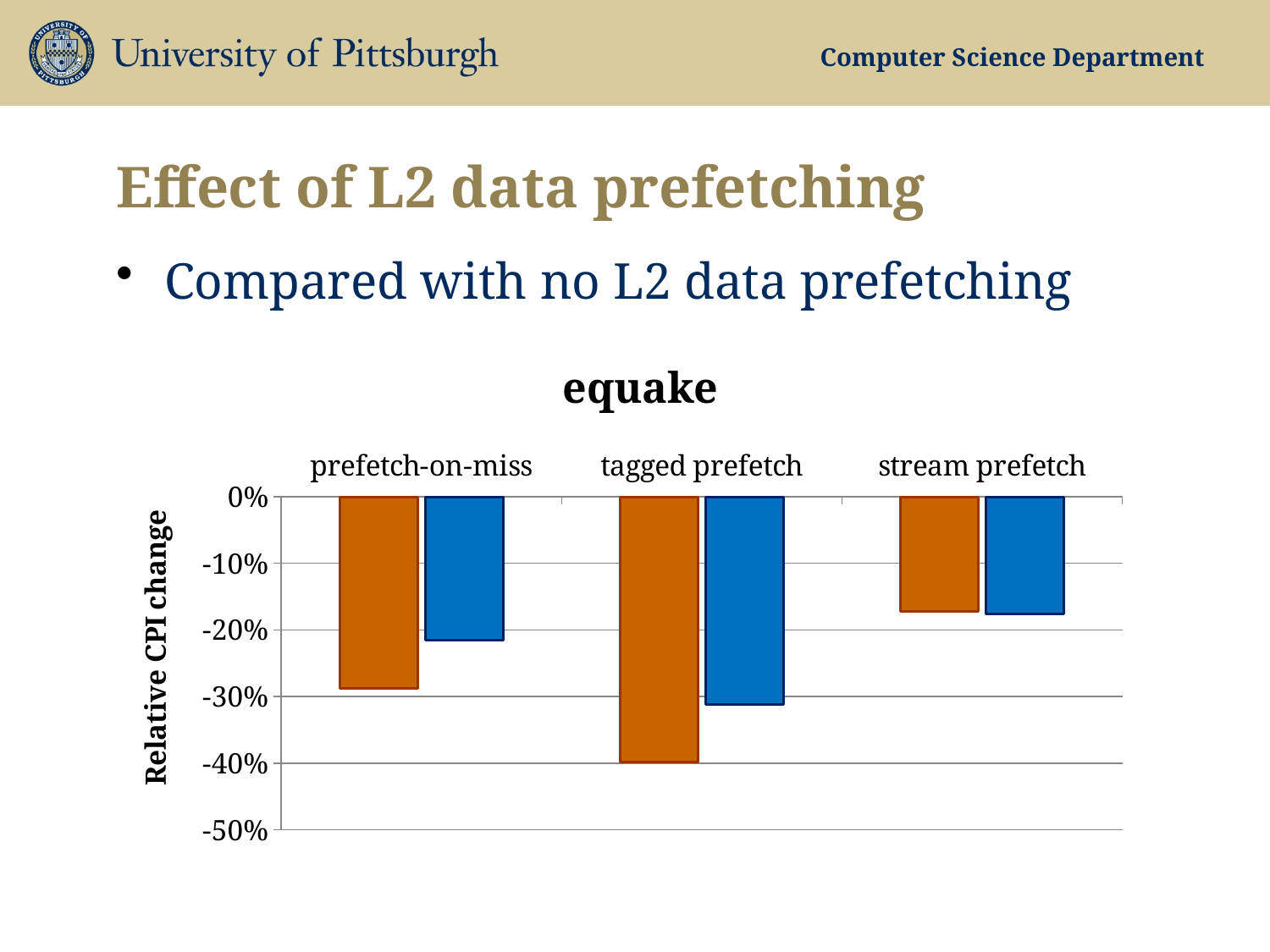
How many prefetching categories are shown along the x axis of the chart? 3 For prefetch-on-miss, which bar shows the larger CPI reduction, the orange bar or the blue bar? orange bar How many bars are plotted for each category in the chart? 2 Is the value of the blue bar for prefetch-on-miss greater or less than -10%? less Which category has the lowest (most negative) relative CPI change in the chart? tagged prefetch Is the value of the orange bar for prefetch-on-miss greater or less than -20%? less What kind of chart is shown on the slide? bar chart Is the value of the orange bar for stream prefetch greater or less than -20%? greater Which category shows the smallest reduction in CPI (bars closest to 0%)? stream prefetch What is the title of the chart? equake What is the label on the vertical axis of the chart? Relative CPI change